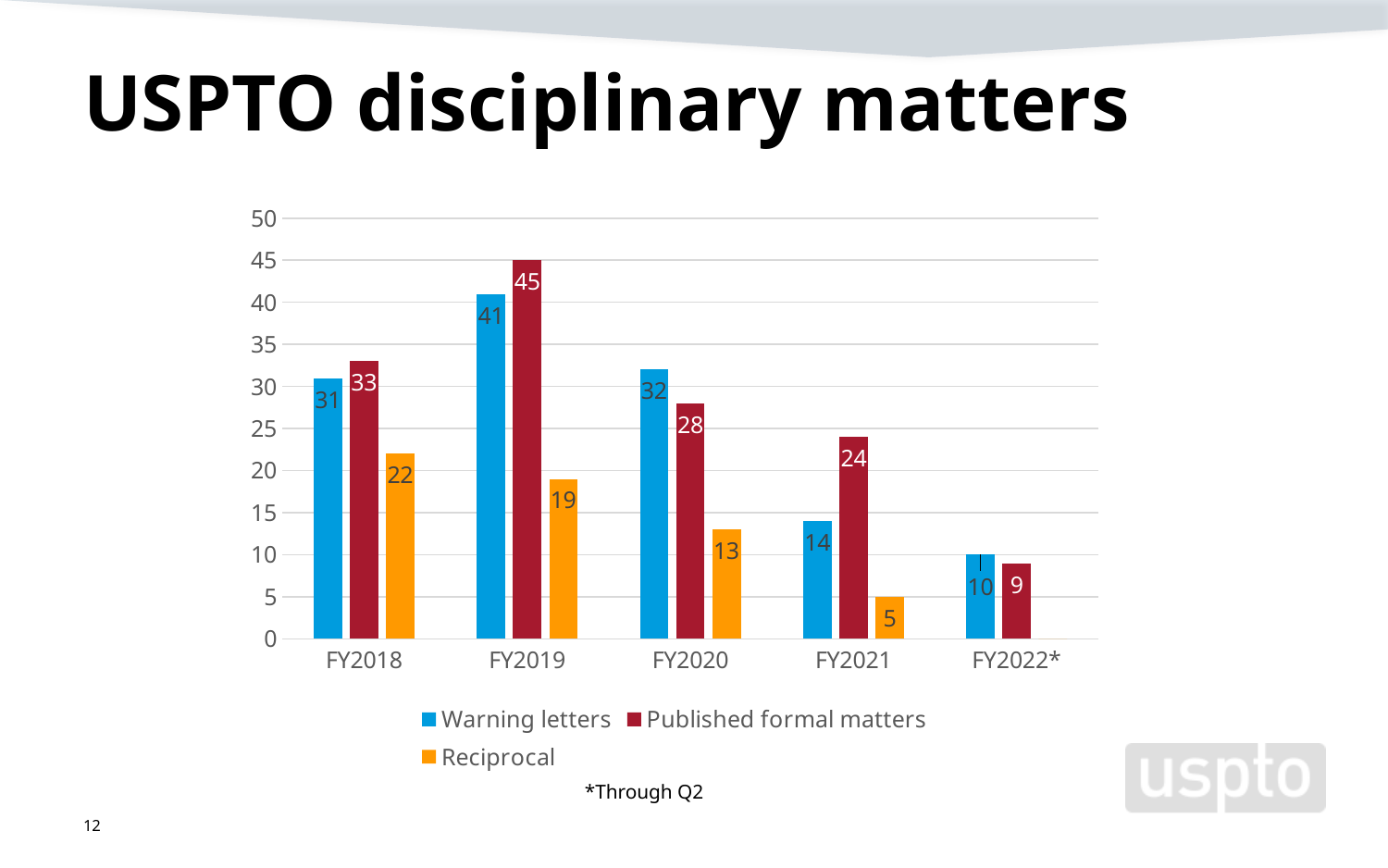
How many series does the legend list? 3 What is the value for Published formal matters in FY2020? 28 What is the value for Reciprocal in FY2021? 5 What kind of chart is shown on the slide? Bar chart What is the difference between Published formal matters and Warning letters in FY2021? 10 What does the asterisk on FY2022* indicate, according to the note below the chart? Through Q2 Do the Reciprocal values rise or fall from FY2018 to FY2021? Fall Which is larger in FY2020, Warning letters or Published formal matters? Warning letters What is the value for Warning letters in FY2019? 41 How many fiscal year categories are shown on the x axis? 5 In which fiscal year is the Warning letters value lowest? FY2022* In which fiscal year is the Published formal matters value highest? FY2019